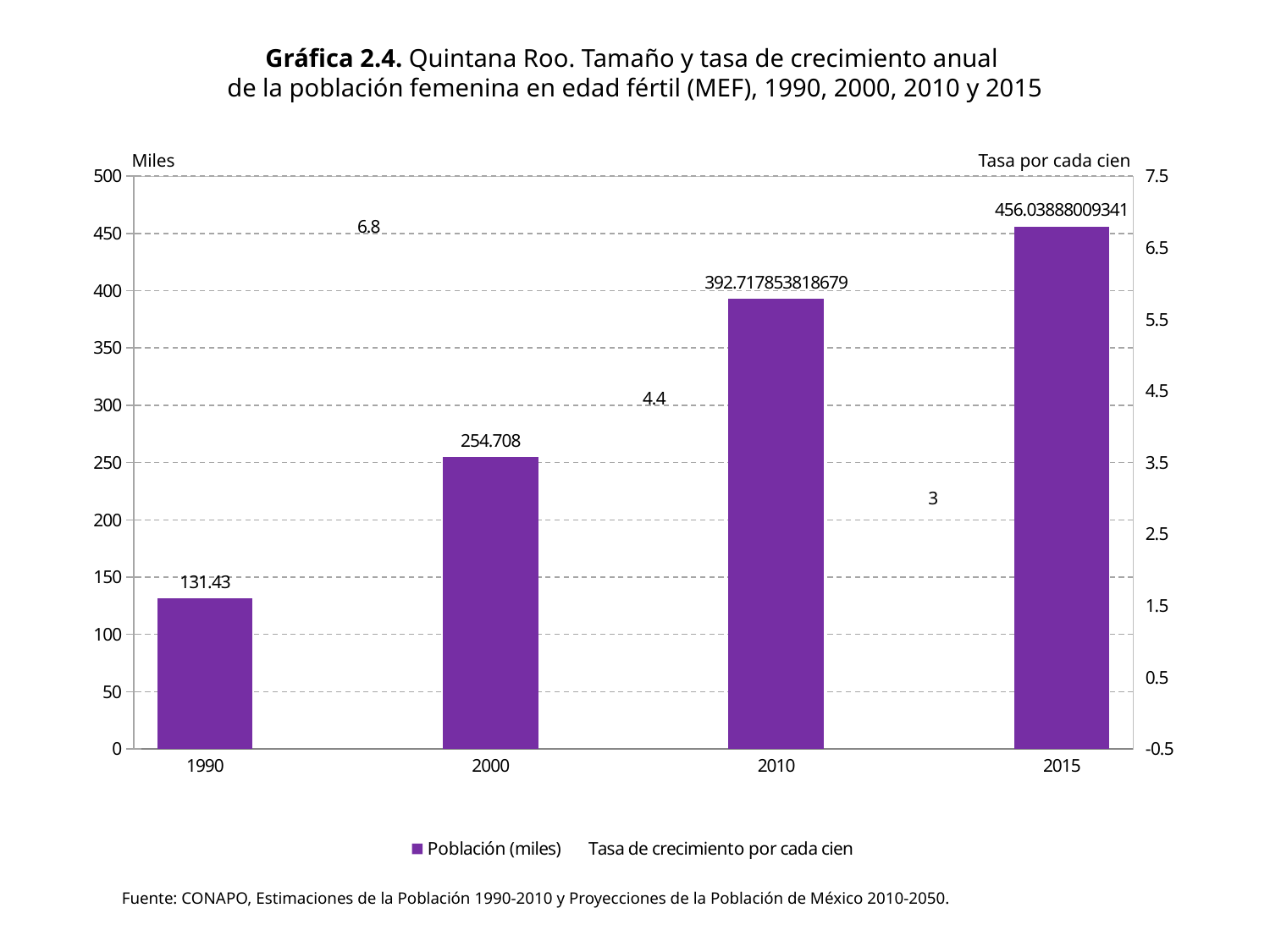
Which year has the highest Población (miles)? 2015 What kind of chart is used to show Población (miles)? bar chart What is the value of Población (miles) for 2000? 254.708 How many series does the legend list? 2 What is the value of Población (miles) for 1990? 131.43 How many years are shown on the x axis? 4 Do the Población (miles) values rise or fall from 1990 to 2015? rise Which is larger, the Población (miles) for 2010 or for 2000? 2010 Is the Población (miles) value for 2010 greater or less than 350? greater Which year has the lowest Población (miles)? 1990 What is the difference between the Población (miles) values for 2000 and 1990? 123.278 What is the value of Población (miles) for 2015? 456.03888009341